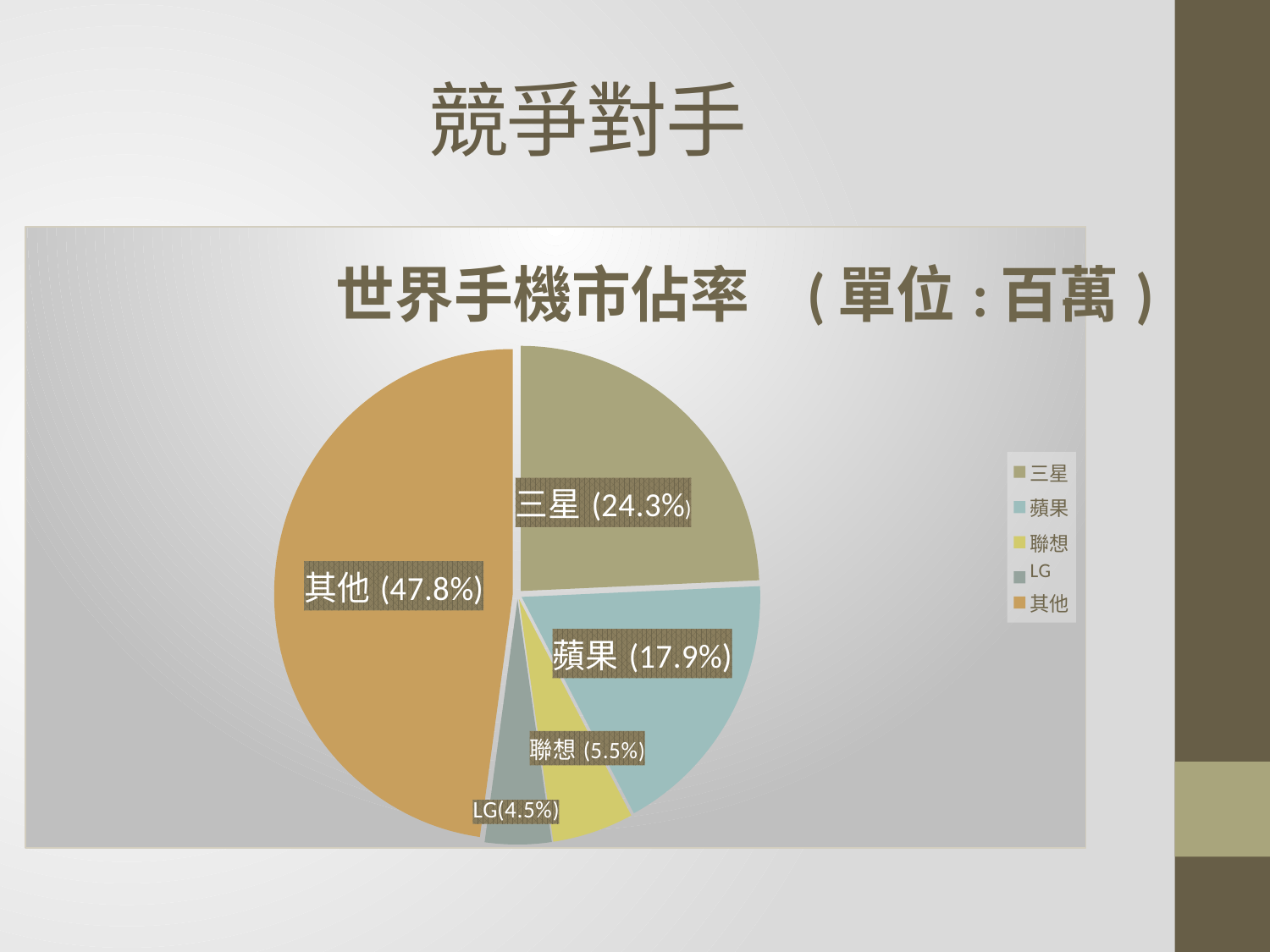
Which slice is larger, 聯想 or LG? 聯想 Which slice of the pie is the largest? 其他 What share of the pie does 聯想 hold? 5.5% What share of the pie does 蘋果 hold? 17.9% What share of the pie does 其他 hold? 47.8% What kind of chart is shown on the slide? Pie chart What is the title of the chart? 世界手機市佔率 （單位：百萬） What is the difference in percentage points between the 三星 and 蘋果 slices? 6.4 How many slices does the pie chart have? 5 Which slice of the pie is the smallest? LG What share of the pie does 三星 hold? 24.3% What share of the pie does LG hold? 4.5%